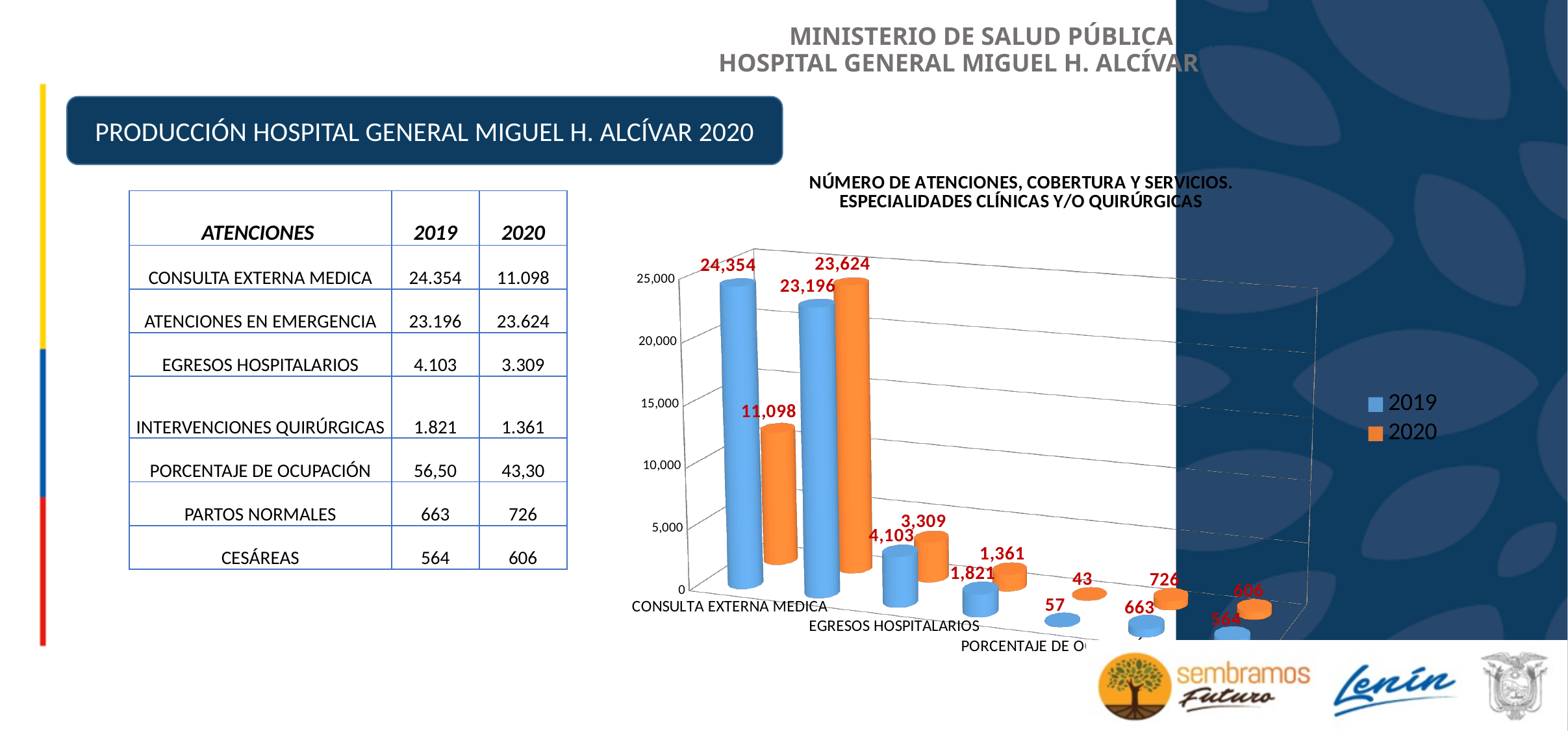
What is the 2019 value for EGRESOS HOSPITALARIOS in the chart? 4,103 What is the highest data label shown for the 2020 series in the chart? 23,624 How many series does the chart legend list? 2 Which category has the highest 2019 value in the chart? CONSULTA EXTERNA MEDICA For CONSULTA EXTERNA MEDICA, which year has the larger value in the chart, 2019 or 2020? 2019 What is the 2020 value for CONSULTA EXTERNA MEDICA in the chart? 11,098 What is the 2020 value for EGRESOS HOSPITALARIOS in the chart? 3,309 What type of chart is shown on the slide? bar chart Is the 2020 value for CONSULTA EXTERNA MEDICA greater or less than 15,000? less By how much did CONSULTA EXTERNA MEDICA fall from 2019 to 2020 according to the chart labels? 13,256 What is the 2019 value for CONSULTA EXTERNA MEDICA in the chart? 24,354 What is the difference between the 2019 and 2020 values for EGRESOS HOSPITALARIOS in the chart? 794